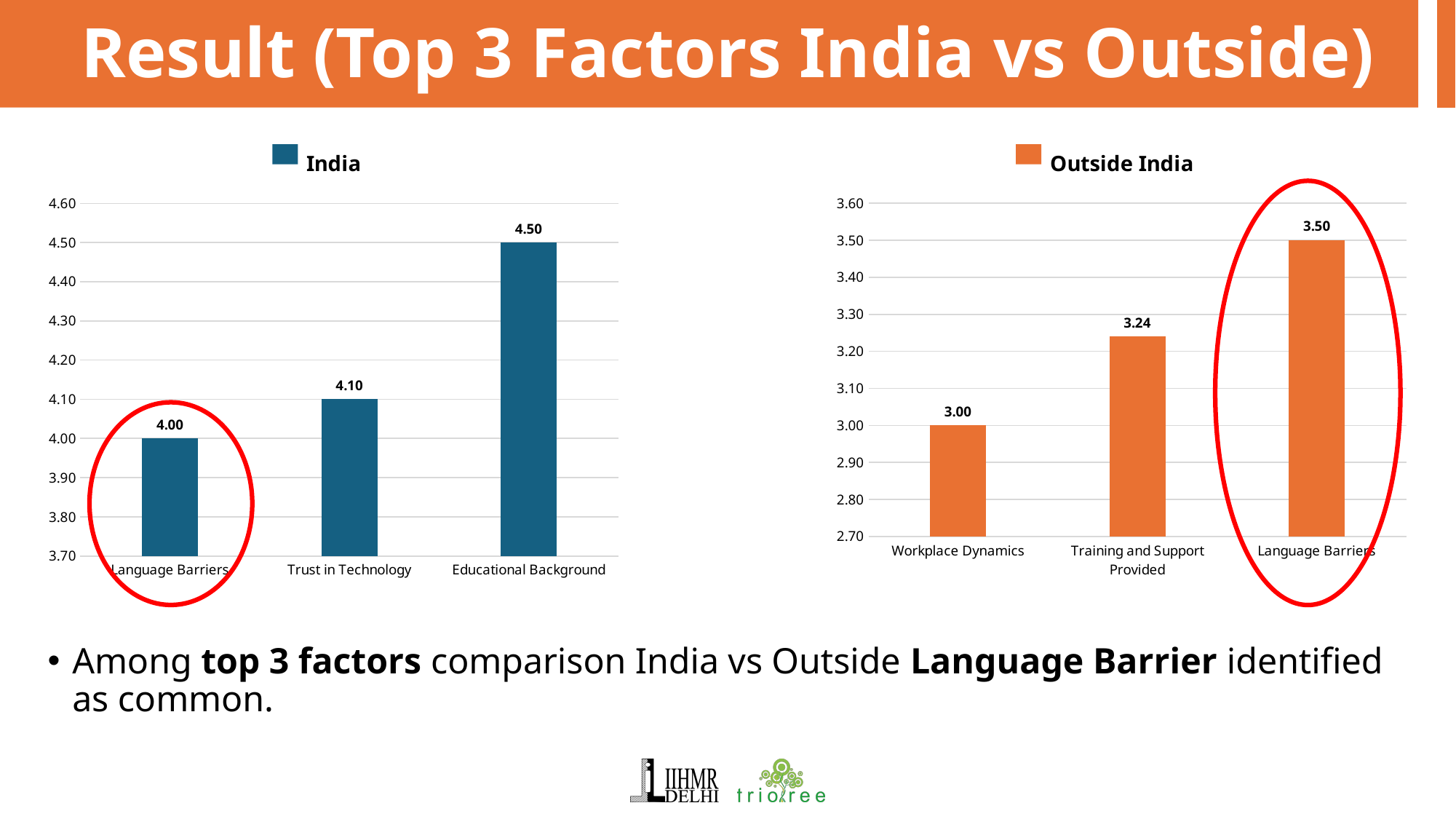
How many categories are shown in the Outside India chart? 3 What is the legend entry of the chart on the right side of the slide? Outside India In the India chart, which category has the highest value? Educational Background In the Outside India chart, which is larger: Training and Support Provided or Language Barriers? Language Barriers In the India chart, what is the difference between Educational Background and Language Barriers? 0.50 In the Outside India chart, which category has the lowest value? Workplace Dynamics In the Outside India chart, what is the difference between Language Barriers and Workplace Dynamics? 0.50 In the India chart, is the value for Educational Background greater or less than 4.40? greater In the Outside India chart, what is the value for Training and Support Provided? 3.24 In the India chart, what is the value for Trust in Technology? 4.10 In the Outside India chart, do the values rise or fall from left to right? rise What kind of chart is the India chart? bar chart